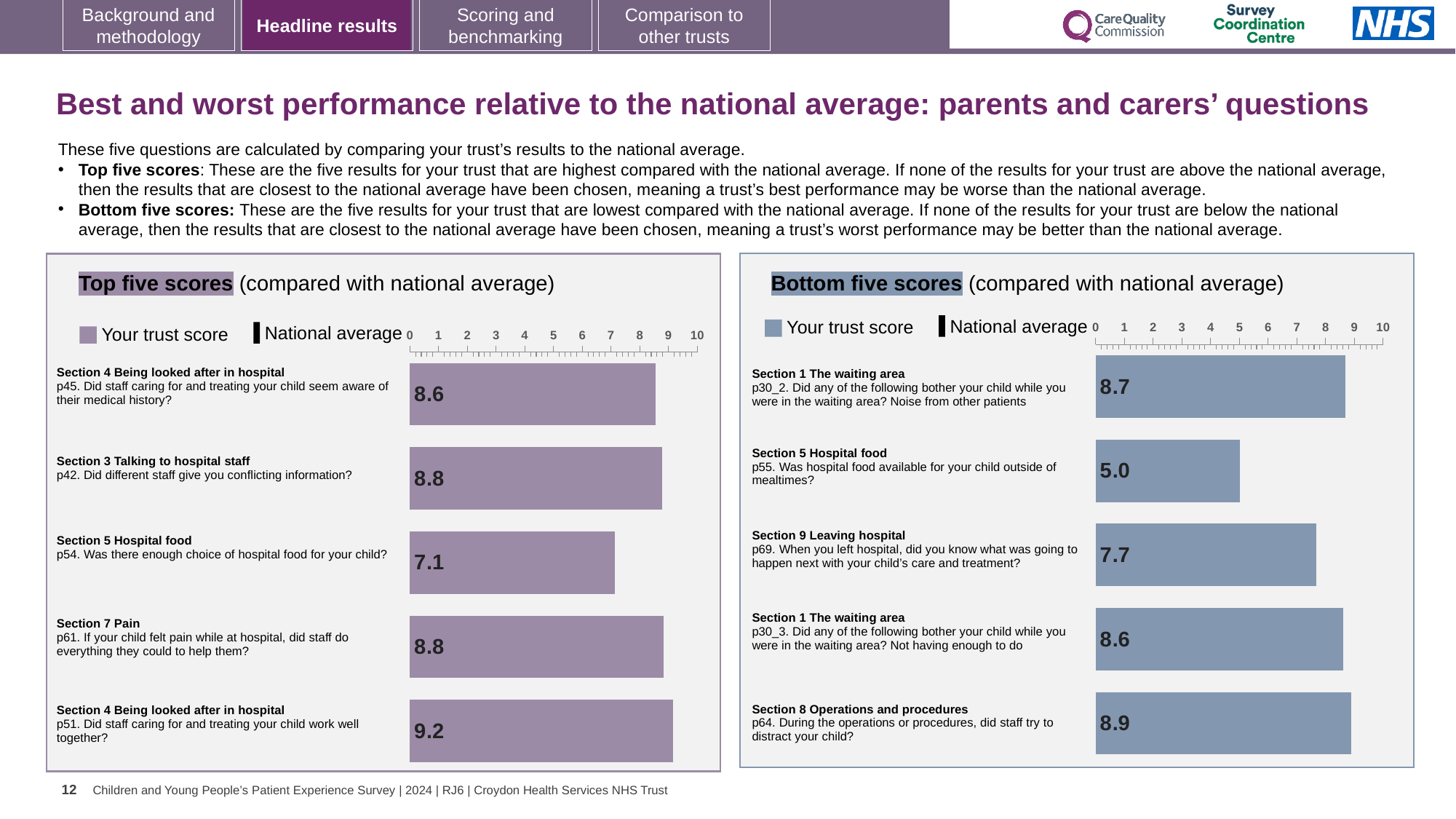
In the Bottom five scores chart, what is the trust score for p55 (Was hospital food available for your child outside of mealtimes?)? 5.0 In the Bottom five scores chart, which question has the highest trust score? p64. During the operations or procedures, did staff try to distract your child? How many questions are plotted in the Bottom five scores chart? 5 In the Top five scores chart, what is the trust score for p54 (Was there enough choice of hospital food for your child?)? 7.1 In the Top five scores chart, what is the difference between the trust scores for p51 and p54? 2.1 What kind of chart is the Top five scores chart? Bar chart In the Top five scores chart, which question has the highest trust score? p51. Did staff caring for and treating your child work well together? In the Top five scores chart, which question has the lowest trust score? p54. Was there enough choice of hospital food for your child? In the Bottom five scores chart, which has the larger trust score: p30_2 (Noise from other patients) or p69 (did you know what was going to happen next)? p30_2 (Noise from other patients) In the Bottom five scores chart, which question has the lowest trust score? p55. Was hospital food available for your child outside of mealtimes? In the Top five scores chart, what is the trust score for p45 (Did staff caring for and treating your child seem aware of their medical history?)? 8.6 In the Bottom five scores chart, what is the trust score for p64 (During the operations or procedures, did staff try to distract your child?)? 8.9